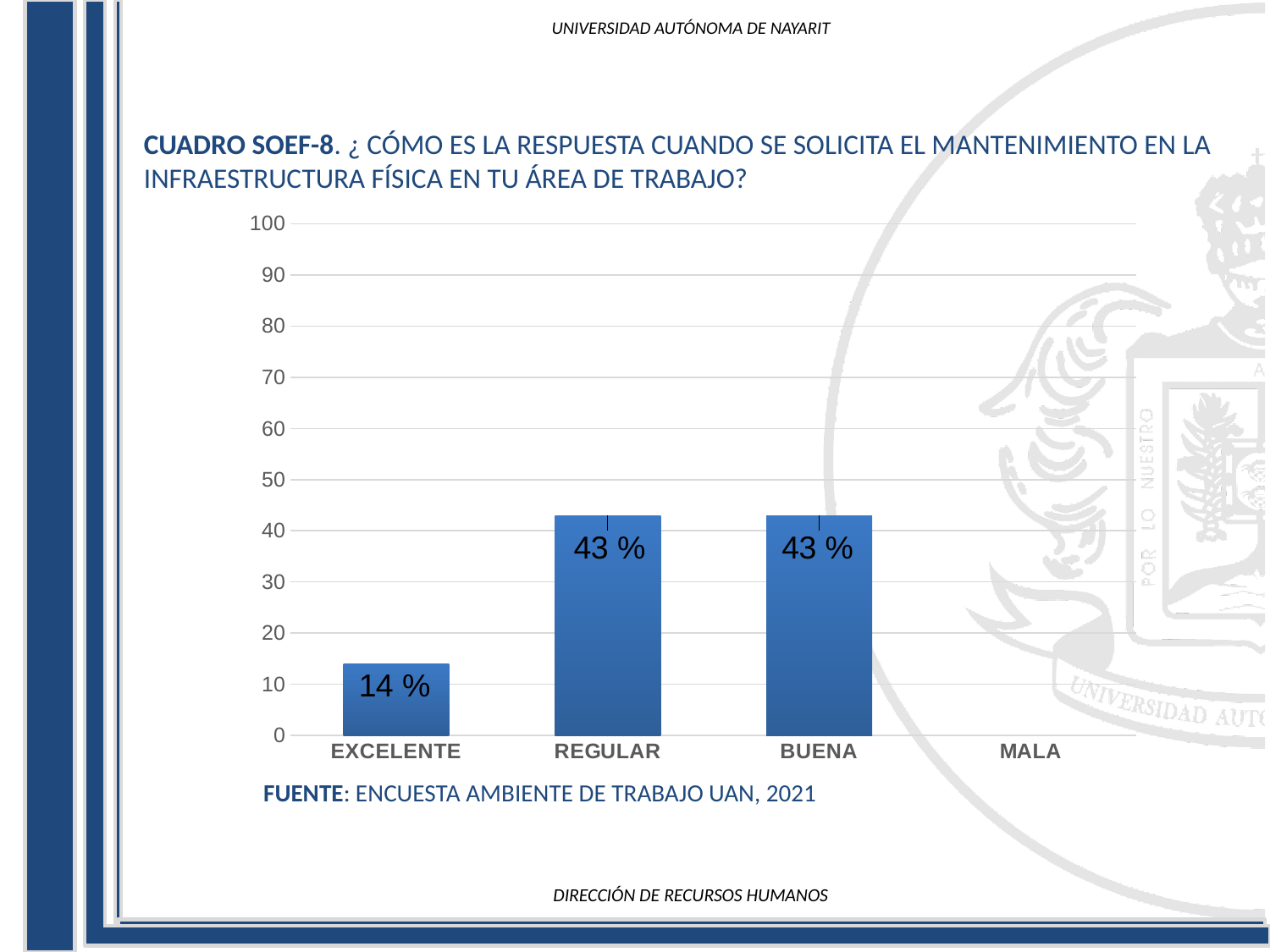
Which is larger, the value for BUENA or the value for EXCELENTE? BUENA What is the value for REGULAR? 43 % What kind of chart is shown on the slide? Bar chart How many categories are shown on the x axis? 4 What is the value for BUENA? 43 % What is the difference between the values for REGULAR and EXCELENTE? 29 % Which category has the shortest visible bar? EXCELENTE Is the value for REGULAR greater or less than 40? greater Do REGULAR and BUENA have the same value? Yes What source is cited below the chart? ENCUESTA AMBIENTE DE TRABAJO UAN, 2021 What is the value for EXCELENTE? 14 % Is the value for EXCELENTE greater or less than 20? less